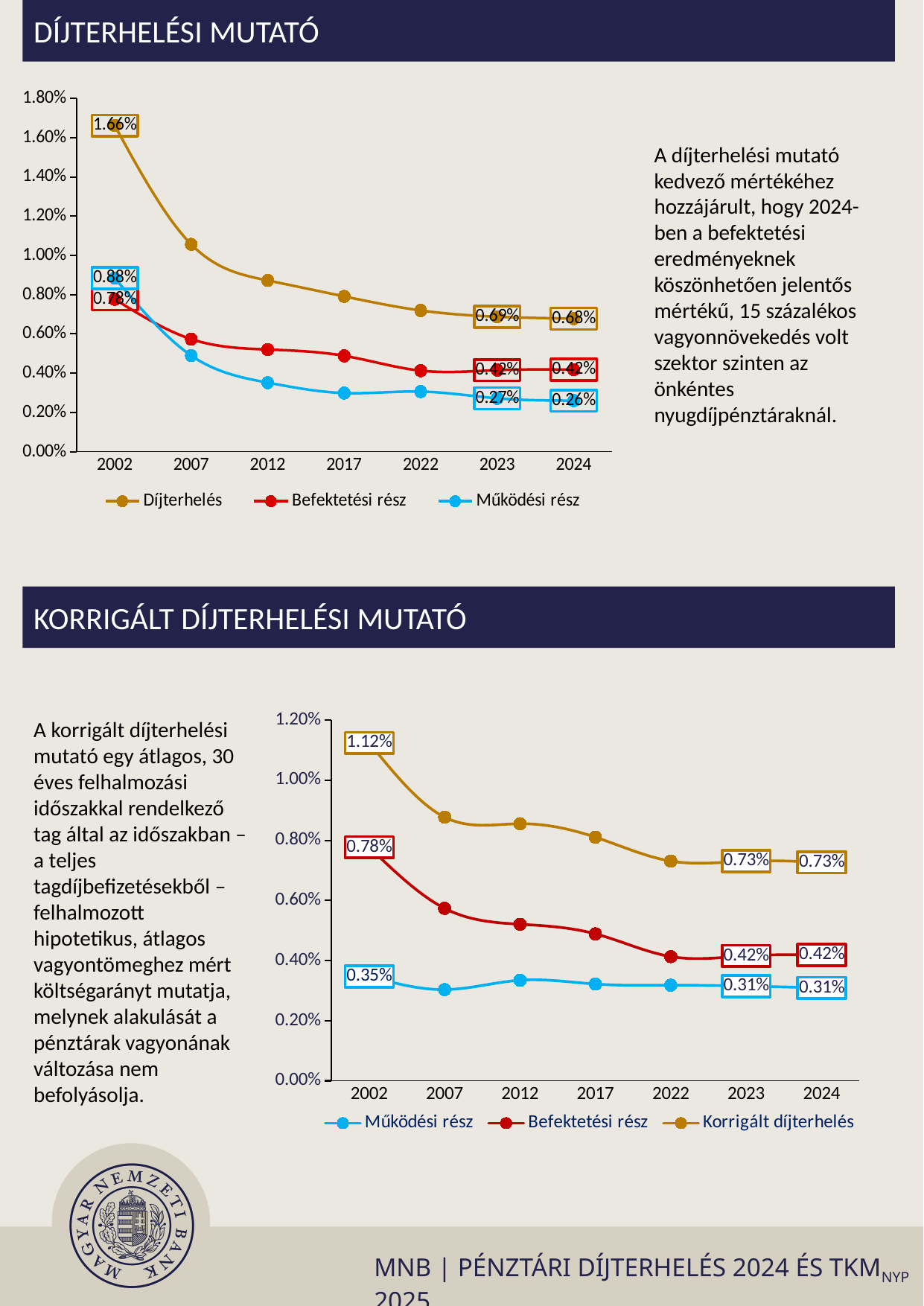
In the Díjterhelési mutató chart, what is the Díjterhelés value for 2002? 1.66% In the Díjterhelési mutató chart, is the Díjterhelés value for 2007 greater or less than 1.00%? greater In the Korrigált díjterhelési mutató chart, which series has the highest value in 2024? Korrigált díjterhelés In the Korrigált díjterhelési mutató chart, what is the Működési rész value for 2023? 0.31% In the Korrigált díjterhelési mutató chart, what is the difference between the Befektetési rész and Működési rész values in 2024? 0.11% In the Díjterhelési mutató chart, by how much did the Díjterhelés value fall from 2002 to 2024? 0.98% In the Díjterhelési mutató chart, what is the Működési rész value for 2024? 0.26% In the Díjterhelési mutató chart, how many series does the legend list? 3 In the Díjterhelési mutató chart, what is the Befektetési rész value for 2023? 0.42% In the Korrigált díjterhelési mutató chart, what is the Korrigált díjterhelés value for 2002? 1.12% In the Díjterhelési mutató chart, does the Díjterhelés series rise or fall from 2002 to 2024? fall What kind of chart is the Korrigált díjterhelési mutató chart? line chart